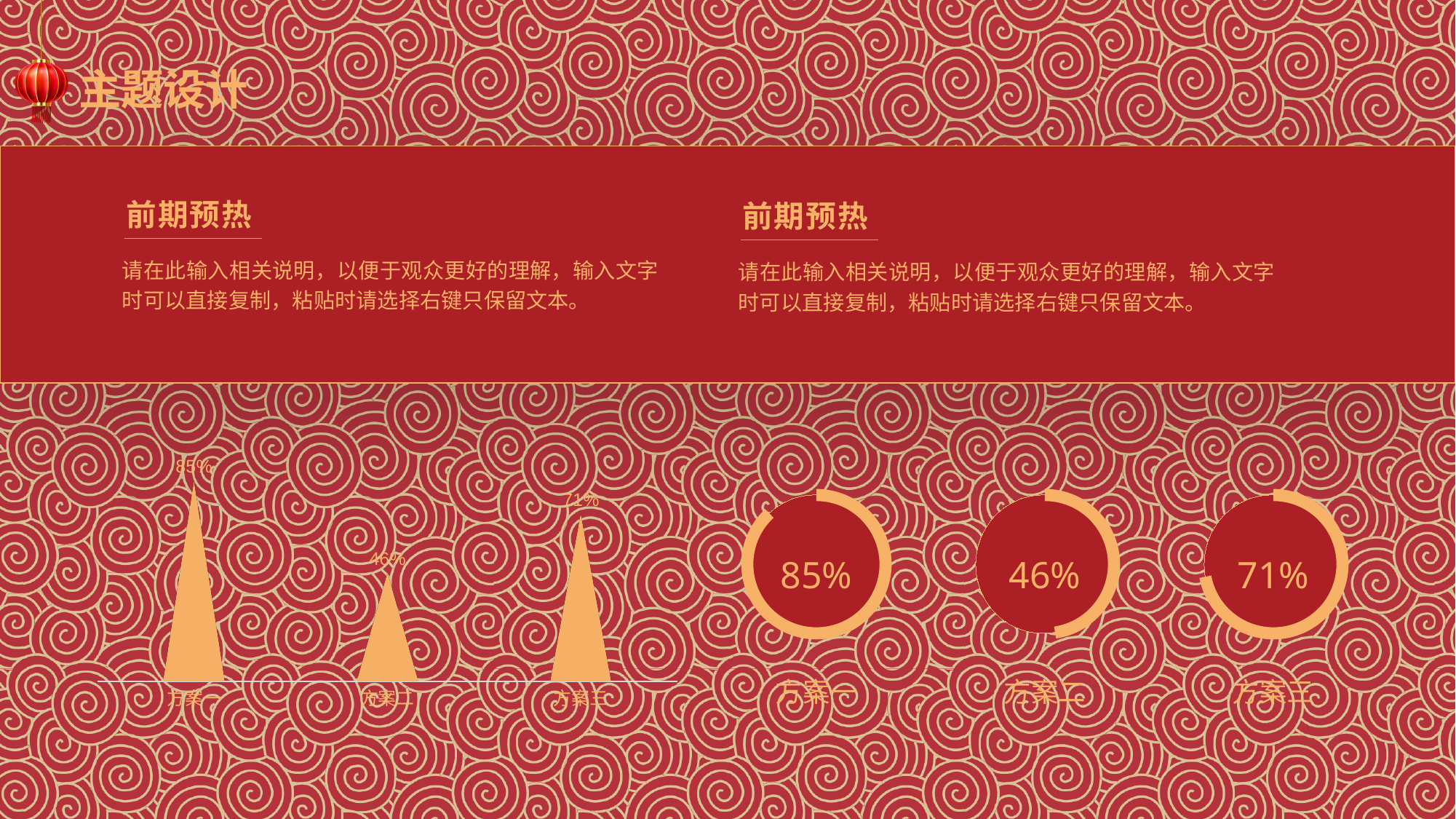
What kind of chart is shown on the left of the slide? bar chart How many categories does the bar chart on the left of the slide show? 3 In the bar chart on the left of the slide, which category has the highest value? 方案一 In the bar chart on the left of the slide, which is larger, the value for 方案三 or the value for 方案二? 方案三 In the donut charts on the right of the slide, what percentage is shown for 方案三? 71% In the bar chart on the left of the slide, what is the value for 方案二? 46% In the bar chart on the left of the slide, what is the difference between the values for 方案一 and 方案二? 39% In the bar chart on the left of the slide, what is the value for 方案一? 85% In the bar chart on the left of the slide, which category has the lowest value? 方案二 In the donut charts on the right of the slide, what percentage is shown for 方案二? 46% In the bar chart on the left of the slide, what is the value for 方案三? 71% How many donut charts are shown on the right of the slide? 3